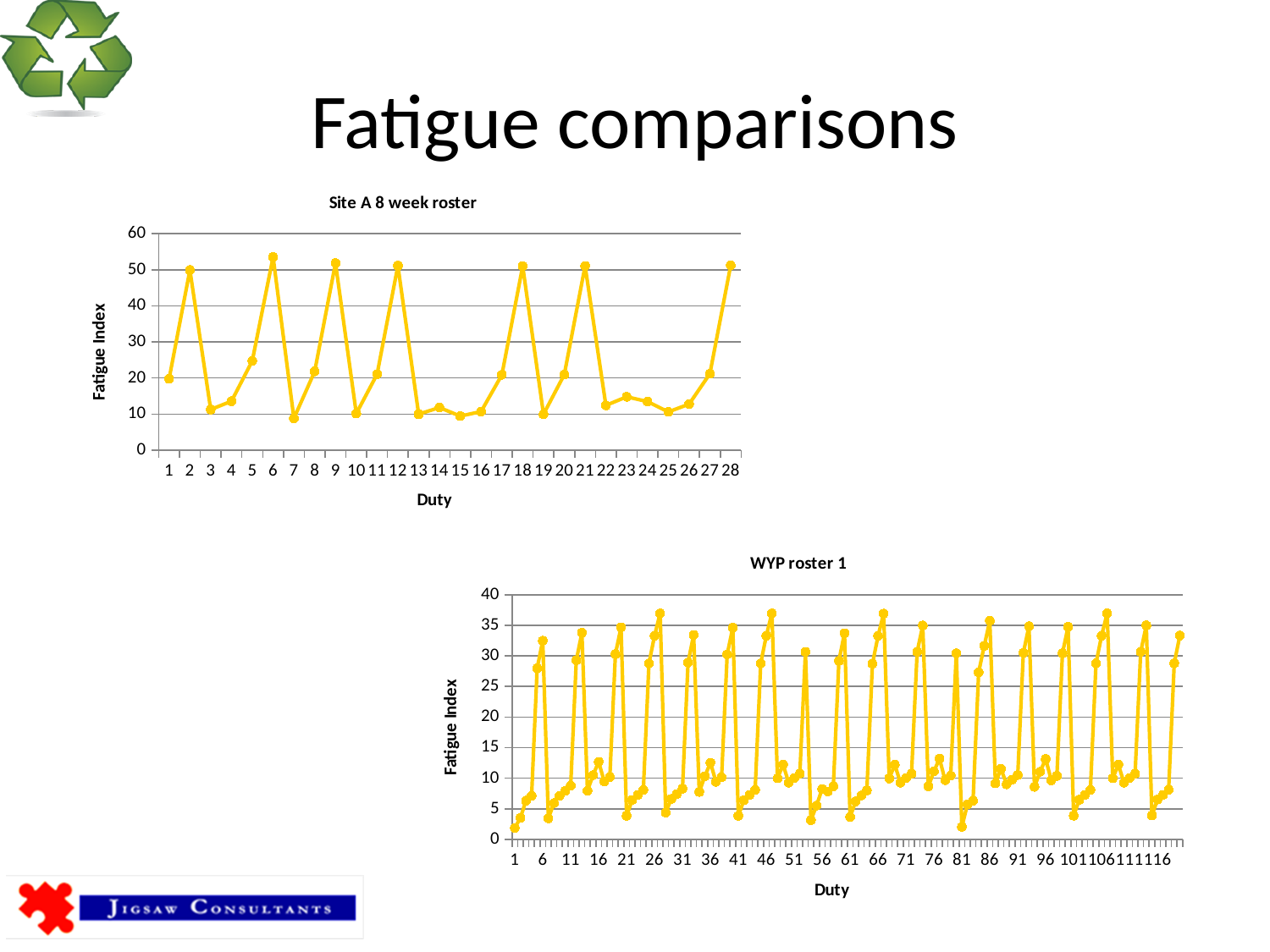
In the 'Site A 8 week roster' chart, which has the higher fatigue index, duty 2 or duty 3? duty 2 What kind of chart is the 'WYP roster 1' chart? line chart What is the x-axis title of the 'Site A 8 week roster' chart? Duty How many duties are plotted on the 'Site A 8 week roster' chart? 28 In the 'Site A 8 week roster' chart, is the value for duty 22 greater or less than 20? less What is the y-axis title of the 'WYP roster 1' chart? Fatigue Index In the 'Site A 8 week roster' chart, which has the higher fatigue index, duty 6 or duty 7? duty 6 In the 'Site A 8 week roster' chart, is the value for duty 1 greater or less than 30? less In the 'WYP roster 1' chart, is the value for duty 1 greater or less than 5? less What kind of chart is the 'Site A 8 week roster' chart? line chart